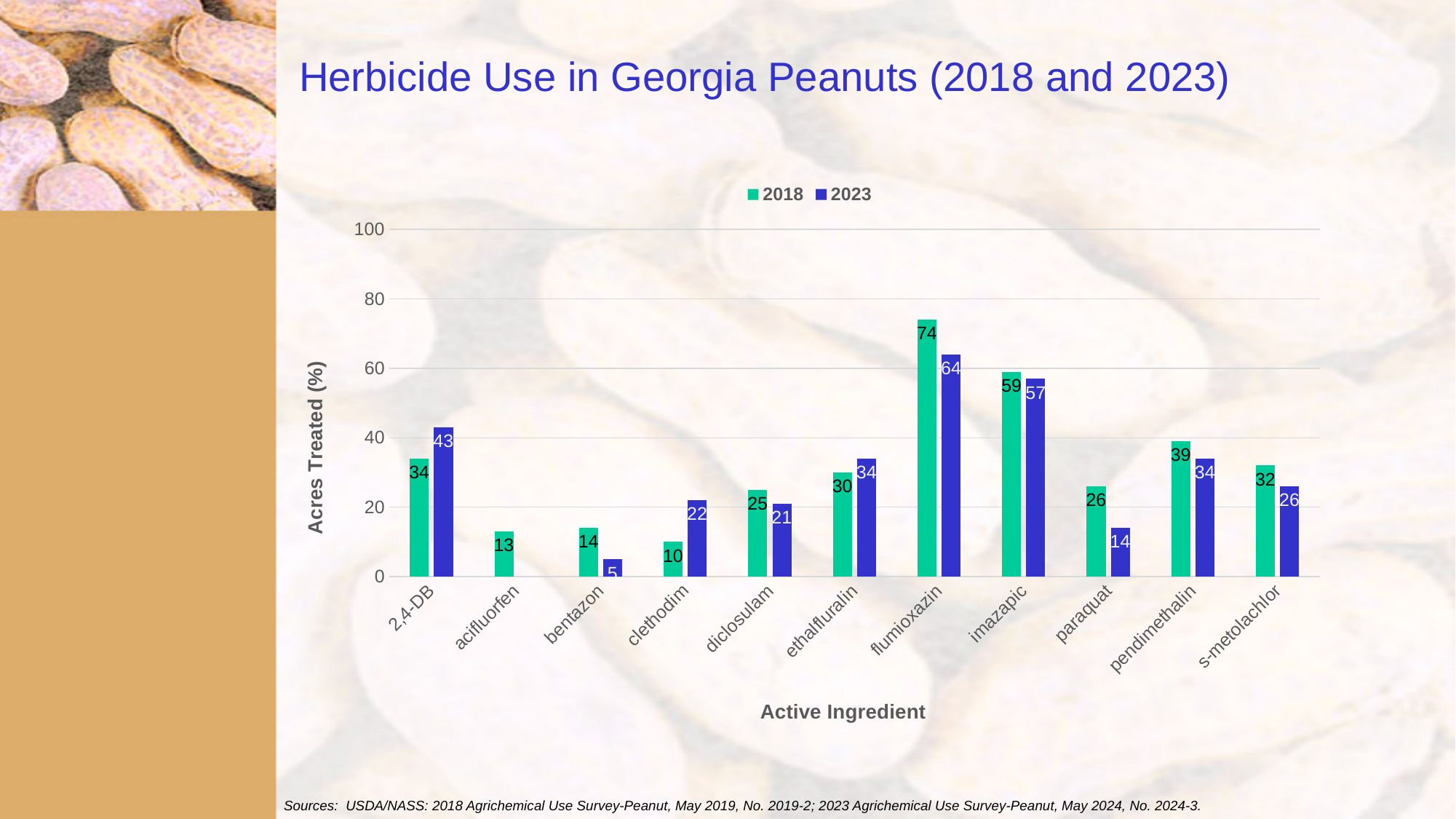
Which active ingredient had the highest percentage of acres treated in 2018? flumioxazin How many active ingredients are shown on the x axis? 11 Which is larger for pendimethalin: the 2018 value or the 2023 value? 2018 What was the percentage of acres treated with flumioxazin in 2018? 74 What is the label of the y axis? Acres Treated (%) Which active ingredient had the lowest percentage of acres treated in 2023? bentazon What is the difference between the 2023 and 2018 values for clethodim? 12 What was the percentage of acres treated with paraquat in 2023? 14 How many series does the legend list? 2 What is the difference between the 2018 and 2023 values for flumioxazin? 10 What was the percentage of acres treated with 2,4-DB in 2023? 43 What kind of chart is shown on the slide? bar chart